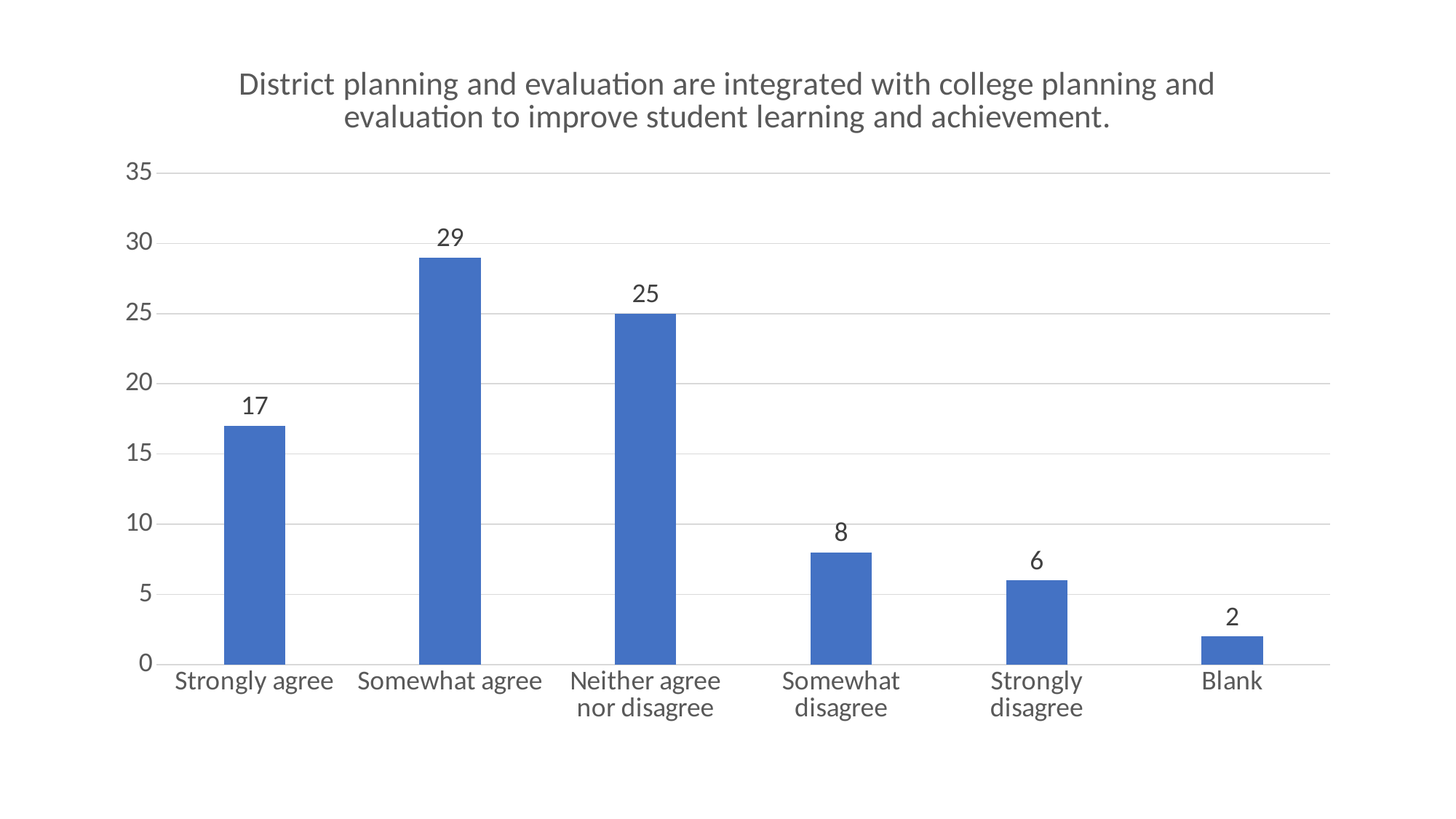
Is the value for Neither agree nor disagree greater or less than 20? greater Which category has the highest value? Somewhat agree What is the value for Neither agree nor disagree? 25 What is the value for Strongly agree? 17 What kind of chart is this? bar chart What is the title of the chart? District planning and evaluation are integrated with college planning and evaluation to improve student learning and achievement. How many categories are shown on the x axis? 6 What is the difference between the values for Somewhat agree and Strongly agree? 12 What is the difference between the values for Somewhat disagree and Strongly disagree? 2 What is the value for Blank? 2 Which is larger, the value for Somewhat disagree or the value for Strongly disagree? Somewhat disagree Which category has the lowest value? Blank